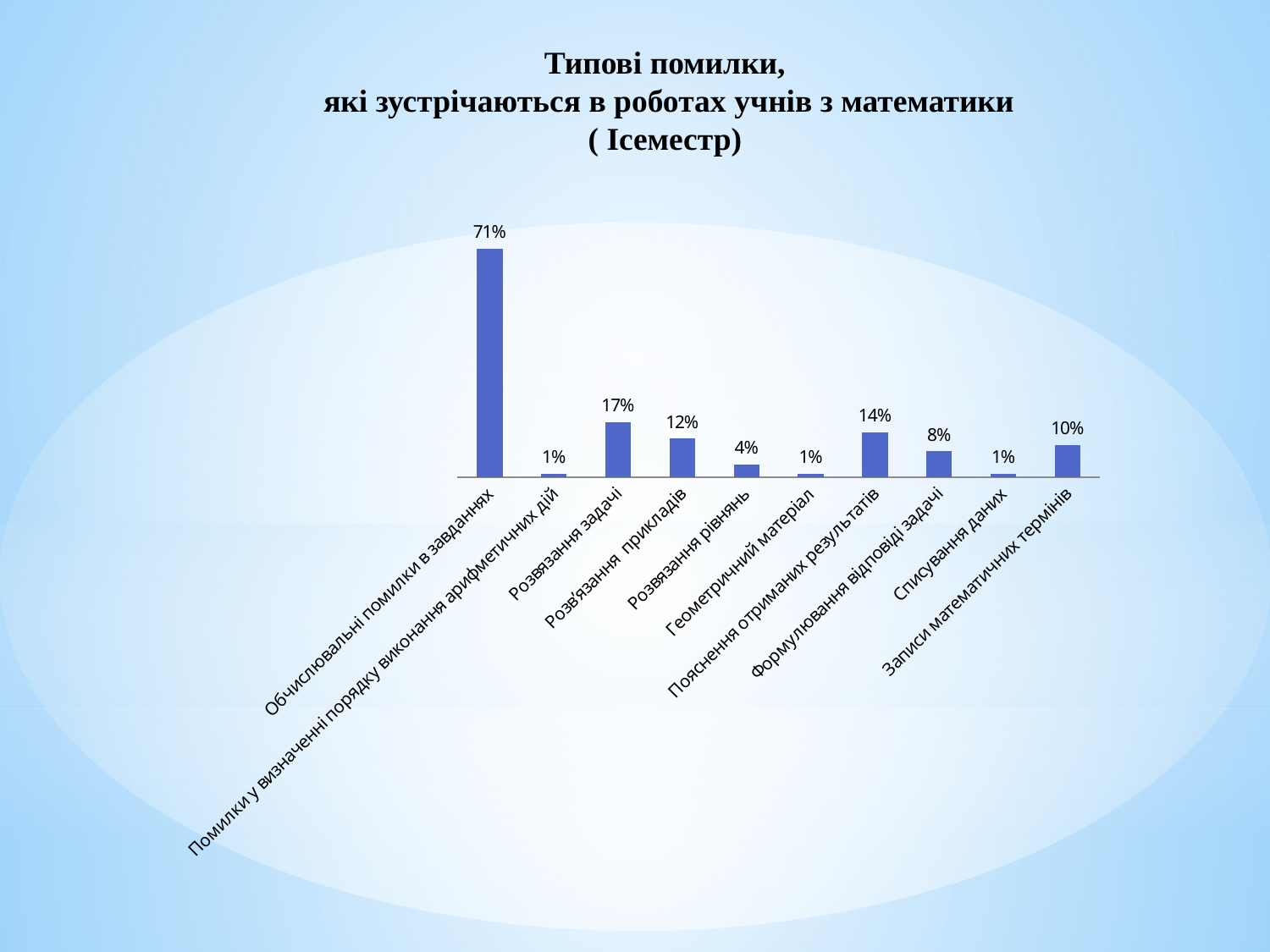
What value is shown for "Розв'язання задачі"? 17% What value is shown for "Записи математичних термінів"? 10% What percentage is shown for "Обчислювальні помилки в завданнях"? 71% What is the difference between the values for "Розв'язання задачі" and "Розв'язання прикладів"? 5% How many categories have a value of 1%? 3 What is the difference between the values for "Обчислювальні помилки в завданнях" and "Пояснення отриманих результатів"? 57% Which is larger, the value for "Розв'язання рівнянь" or the value for "Розв'язання прикладів"? Розв'язання прикладів Which is larger, the value for "Формулювання відповіді задачі" or the value for "Записи математичних термінів"? Записи математичних термінів What percentage is shown for "Пояснення отриманих результатів"? 14% What type of chart is shown on the slide? Bar chart How many categories are shown in the chart? 10 Which category has the highest value? Обчислювальні помилки в завданнях